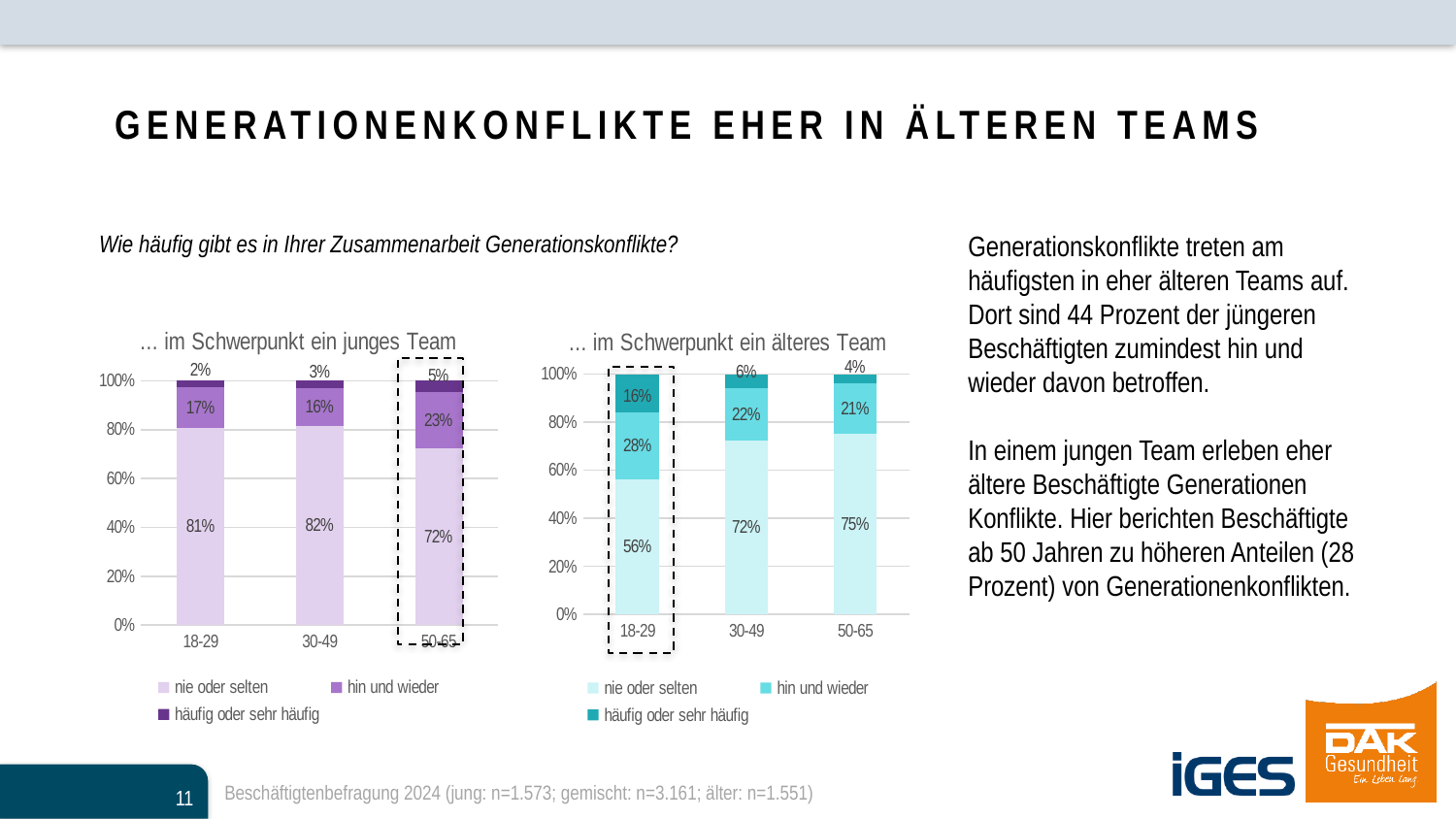
In the chart '… im Schwerpunkt ein junges Team', is the 'nie oder selten' value for 30-49 larger or smaller than the 'nie oder selten' value for 50-65? larger How many series does the legend of the chart '… im Schwerpunkt ein älteres Team' list? 3 In the chart '… im Schwerpunkt ein älteres Team', what is the value for 'häufig oder sehr häufig' in the 18-29 group? 16% What type of chart is '… im Schwerpunkt ein älteres Team'? Stacked bar chart In the chart '… im Schwerpunkt ein junges Team', which age group has the highest value for 'hin und wieder'? 50-65 In the chart '… im Schwerpunkt ein älteres Team', what is the difference between the 'nie oder selten' values for 50-65 and 18-29? 19 percentage points In the chart '… im Schwerpunkt ein junges Team', what is the value for 'nie oder selten' in the 18-29 group? 81% In the chart '… im Schwerpunkt ein älteres Team', does the 'häufig oder sehr häufig' value rise or fall from 18-29 to 50-65? fall How many age groups are shown on the x axis of the chart '… im Schwerpunkt ein junges Team'? 3 In the chart '… im Schwerpunkt ein älteres Team', which age group has the lowest value for 'nie oder selten'? 18-29 In the chart '… im Schwerpunkt ein junges Team', what is the value for 'hin und wieder' in the 50-65 group? 23% In the chart '… im Schwerpunkt ein älteres Team', what is the value for 'nie oder selten' in the 50-65 group? 75%